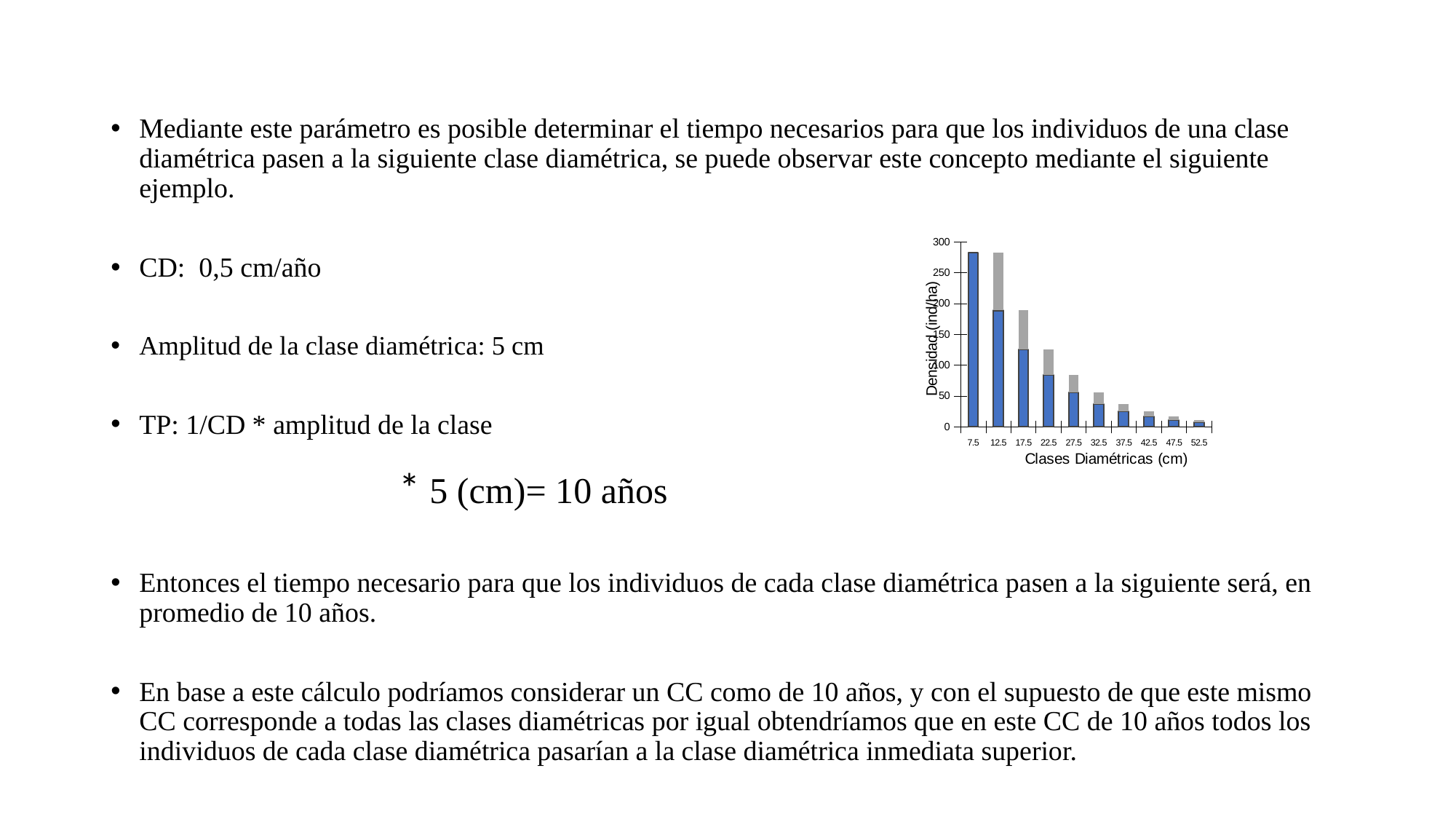
Is the blue bar value for the 22.5 cm class greater or less than 100? less What is the title of the x axis of the chart? Clases Diamétricas (cm) Is the blue bar value for the 12.5 cm class greater or less than 250? less Do the bar values rise or fall as the diameter class increases along the x axis? fall Is the blue bar value for the 17.5 cm class greater or less than 100? greater Which has the larger blue bar, the 12.5 cm class or the 17.5 cm class? 12.5 Which diameter class has the lowest density in the chart? 52.5 Which diameter class has the highest density in the chart? 7.5 How many diameter classes are shown on the x axis of the chart? 10 What kind of chart is shown on the slide? bar chart What is the title of the y axis of the chart? Densidad (ind/ha)